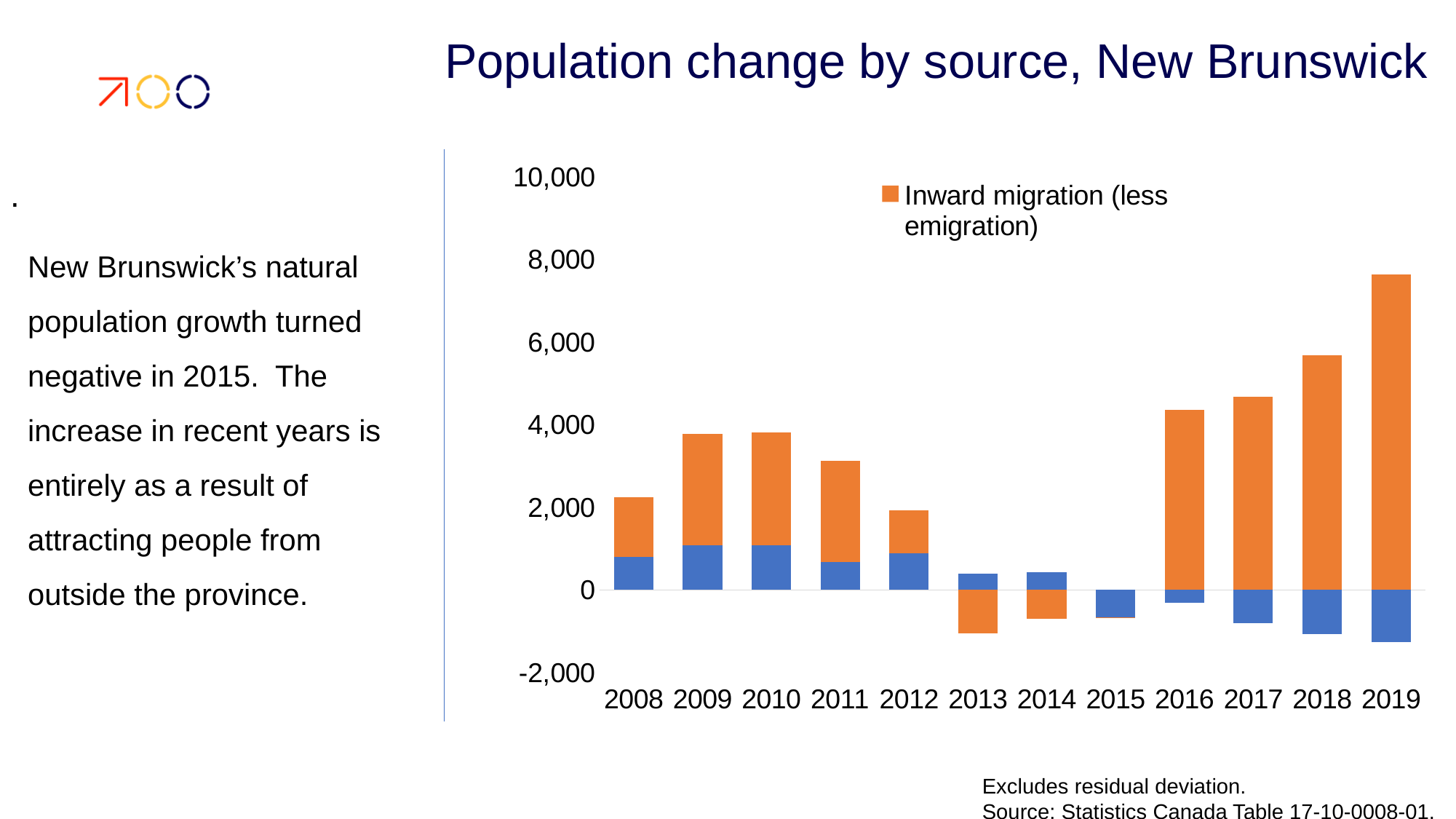
Is the value for Inward migration (less emigration) in 2013 greater or less than 0? less What is the first year shown on the x axis? 2008 Is the value for Inward migration (less emigration) in 2019 greater or less than 6,000? greater Which year has the highest value for Inward migration (less emigration)? 2019 Is the value for Inward migration (less emigration) in 2018 greater or less than 4,000? greater What is the title of the chart? Population change by source, New Brunswick Which year has the lowest value for Inward migration (less emigration)? 2013 Does the value for Inward migration (less emigration) rise or fall from 2015 to 2019? rise What kind of chart is shown on the slide? Stacked bar chart How many series does the chart's legend list? 1 Which year has the larger value for Inward migration (less emigration), 2017 or 2018? 2018 How many years are shown on the x axis of the chart? 12